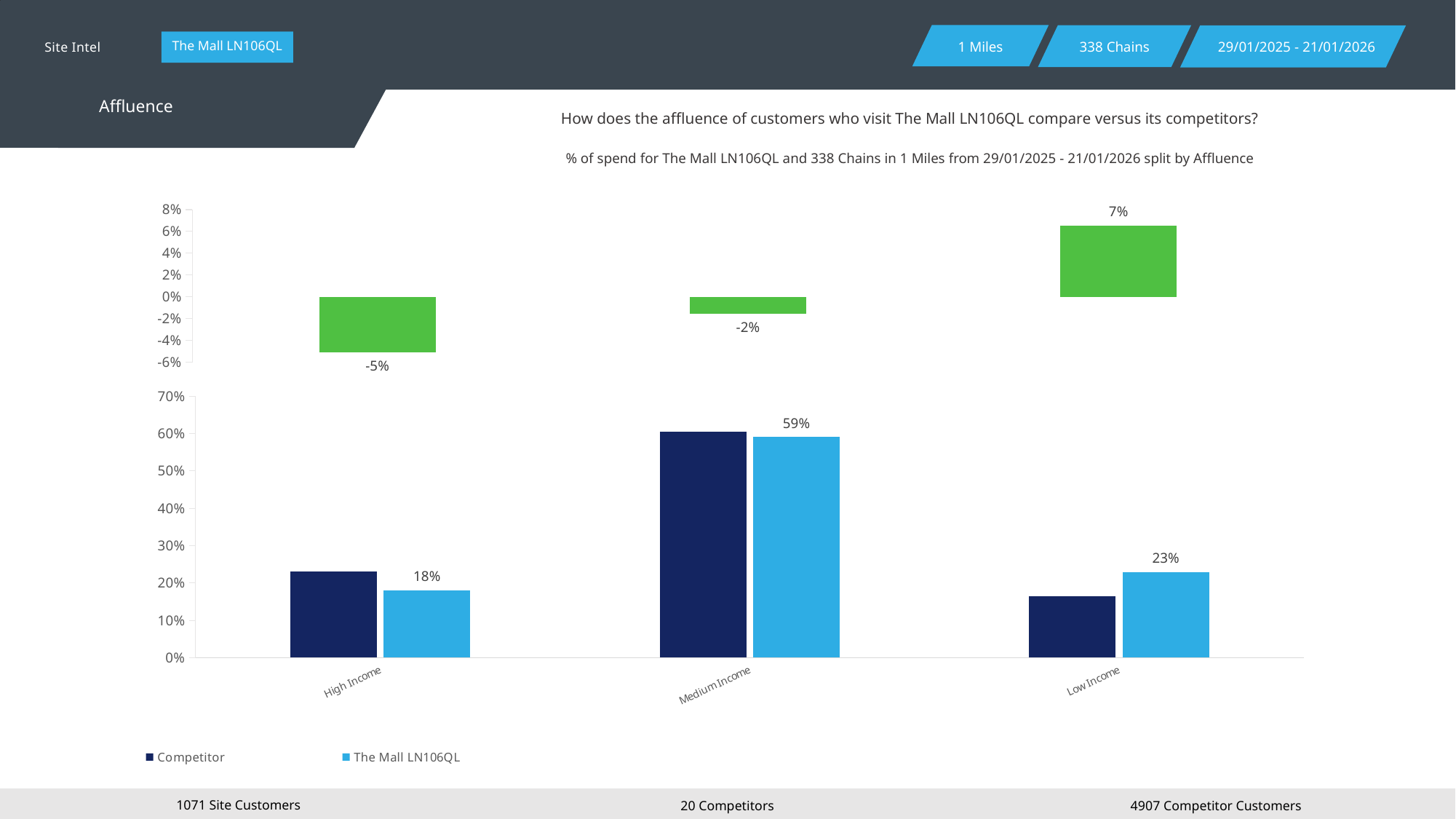
In the top chart, which category has the lowest value? High Income In the bottom chart, is the Competitor value for Medium Income greater or less than 50%? greater In the bottom chart, what is the value for The Mall LN106QL in the High Income category? 18% In the bottom chart, what is the value for The Mall LN106QL in the Low Income category? 23% In the top chart, what is the value shown for the Low Income category? 7% In the bottom chart, which is larger for the Low Income category: Competitor or The Mall LN106QL? The Mall LN106QL In the bottom chart, is the Competitor value for Low Income greater or less than 20%? less How many series does the legend of the bottom chart list? 2 In the bottom chart, what is the value for The Mall LN106QL in the Medium Income category? 59% In the bottom chart, what is the difference between The Mall LN106QL's Medium Income value and its High Income value? 41% In the bottom chart, which category has the highest value for The Mall LN106QL? Medium Income In the top chart, what is the value shown for the High Income category? -5%